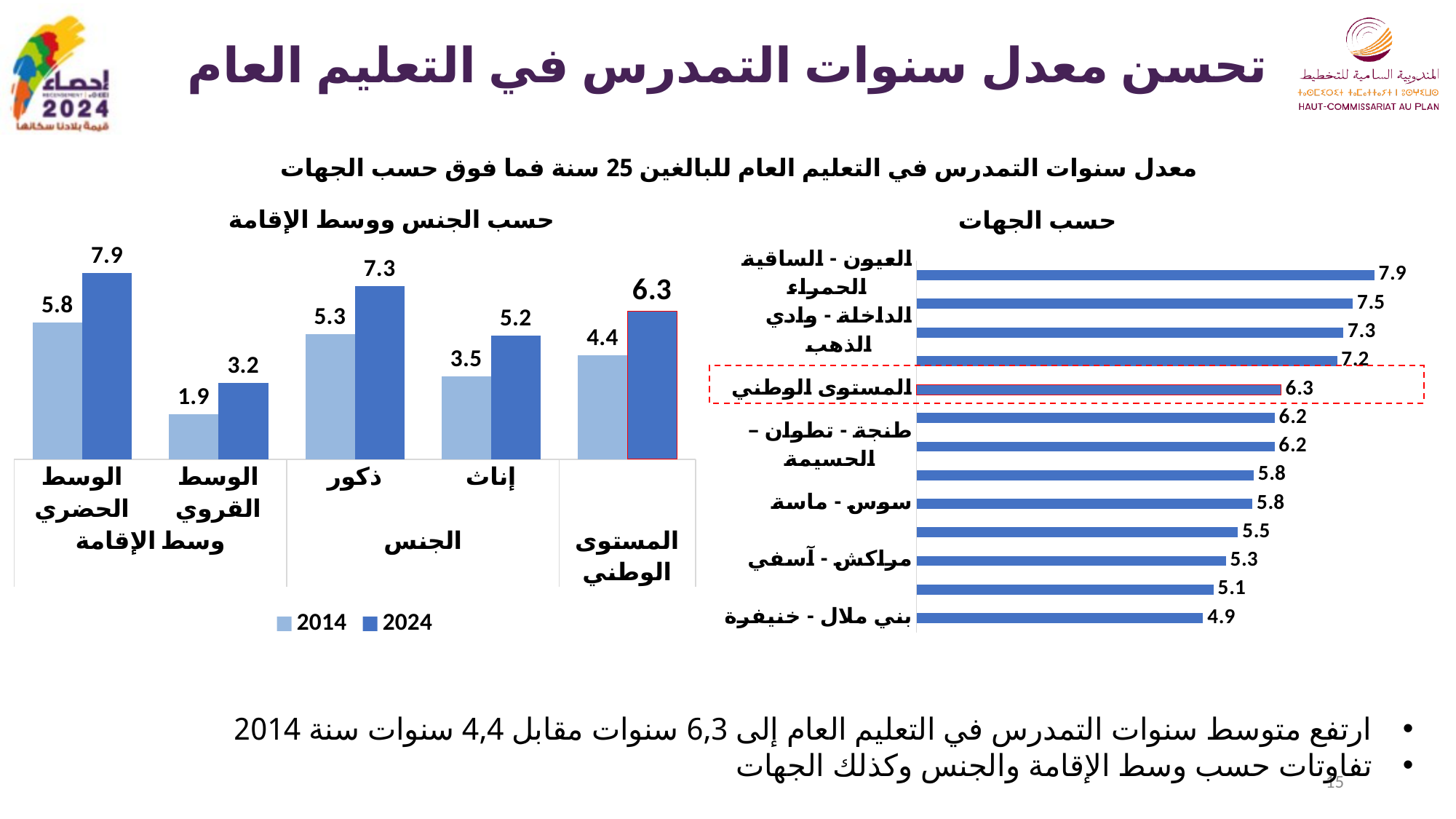
In the chart titled حسب الجنس ووسط الإقامة, which category has the lowest 2024 value? الوسط القروي In the chart titled حسب الجنس ووسط الإقامة, what is the 2014 value for الوسط القروي? 1.9 In the chart titled حسب الجنس ووسط الإقامة, what is the difference between the 2024 and 2014 values for المستوى الوطني? 1.9 How many series does the legend of the chart titled حسب الجنس ووسط الإقامة list? 2 In the chart titled حسب الجهات, which region has the lowest value? بني ملال - خنيفرة In the chart titled حسب الجهات, what is the highest value shown? 7.9 In the chart titled حسب الجهات, what is the value for المستوى الوطني? 6.3 What kind of chart is the chart titled حسب الجهات? bar chart In the chart titled حسب الجنس ووسط الإقامة, what is the 2024 value for الوسط الحضري? 7.9 In the chart titled حسب الجنس ووسط الإقامة, which is larger: the 2024 value for ذكور or the 2024 value for إناث? ذكور In the chart titled حسب الجنس ووسط الإقامة, what is the difference between the 2024 and 2014 values for ذكور? 2.0 In the chart titled حسب الجنس ووسط الإقامة, what is the 2024 value for إناث? 5.2